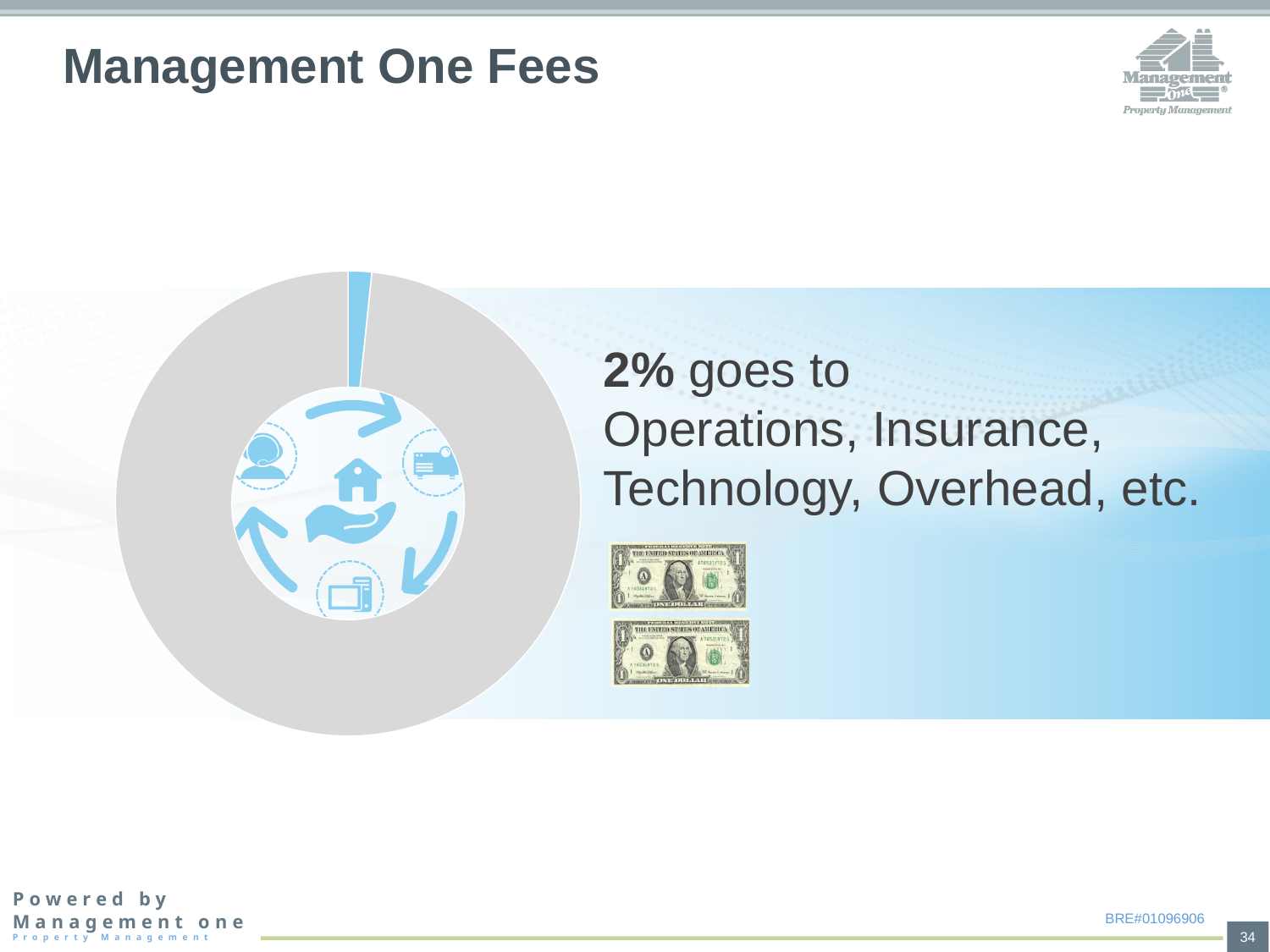
What colour is the small slice of the doughnut chart? Blue According to the slide, what does the 2% slice go to? Operations, Insurance, Technology, Overhead, etc. Which slice of the doughnut chart is larger, the grey slice or the blue slice? The grey slice Is the share of the small blue slice greater or less than 50%? less What share of the doughnut chart does the small blue slice represent? 2% What kind of chart is shown on the slide? Doughnut chart How many slices does the doughnut chart have? 2